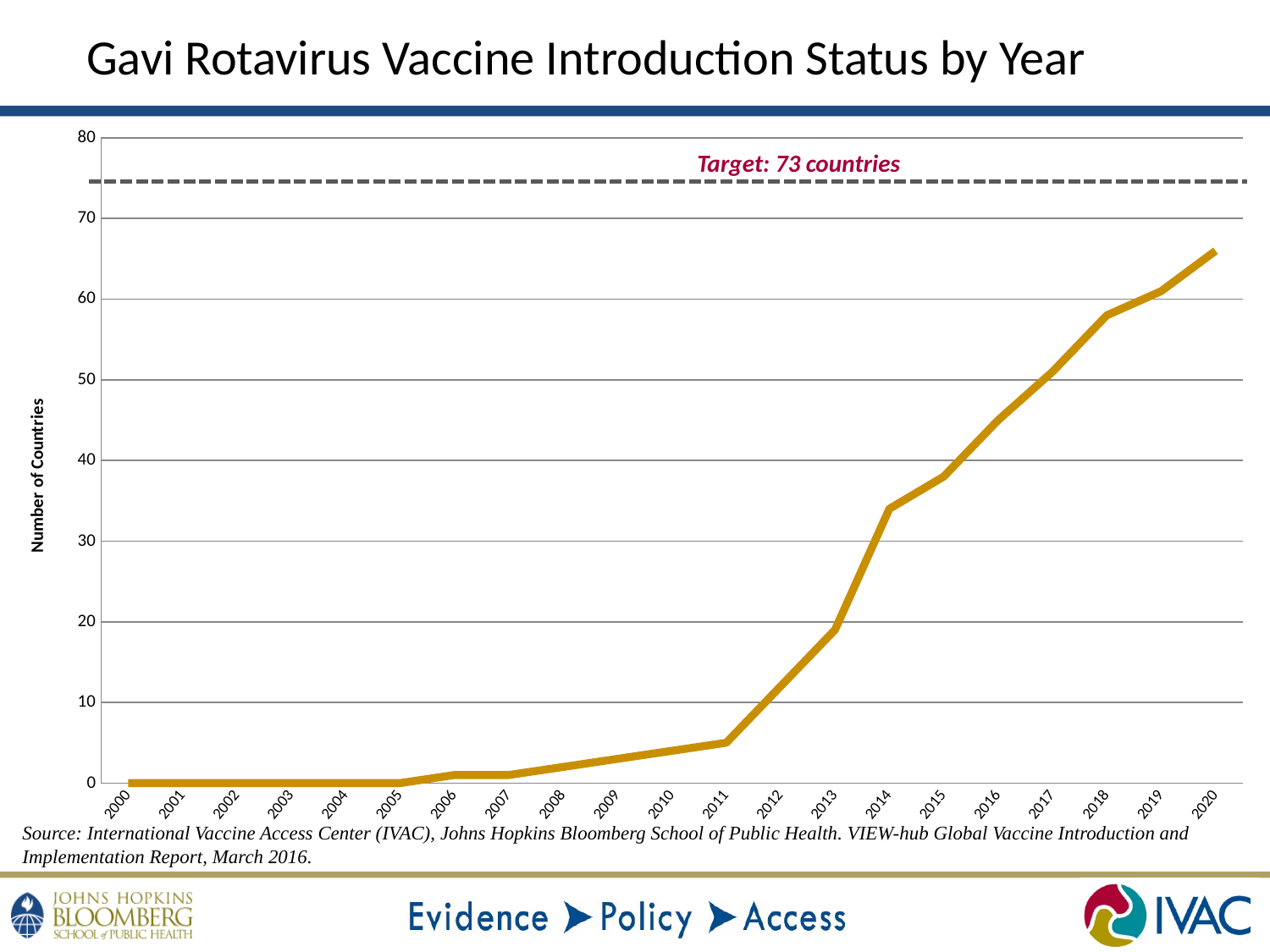
What is the title of the chart? Gavi Rotavirus Vaccine Introduction Status by Year Is the number of countries for 2018 greater or less than 60? less Which year has the highest number of countries on the chart? 2020 What is the number of countries shown for 2000? 0 What type of chart is shown on the slide? Line chart How many years are shown on the x axis of the chart? 21 Is the number of countries for 2020 greater or less than 60? greater Which year has a larger number of countries, 2012 or 2015? 2015 Is the number of countries for 2011 greater or less than 10? less What target value is marked by the dashed line on the chart? 73 countries Does the number of countries rise or fall from 2011 to 2020? Rise